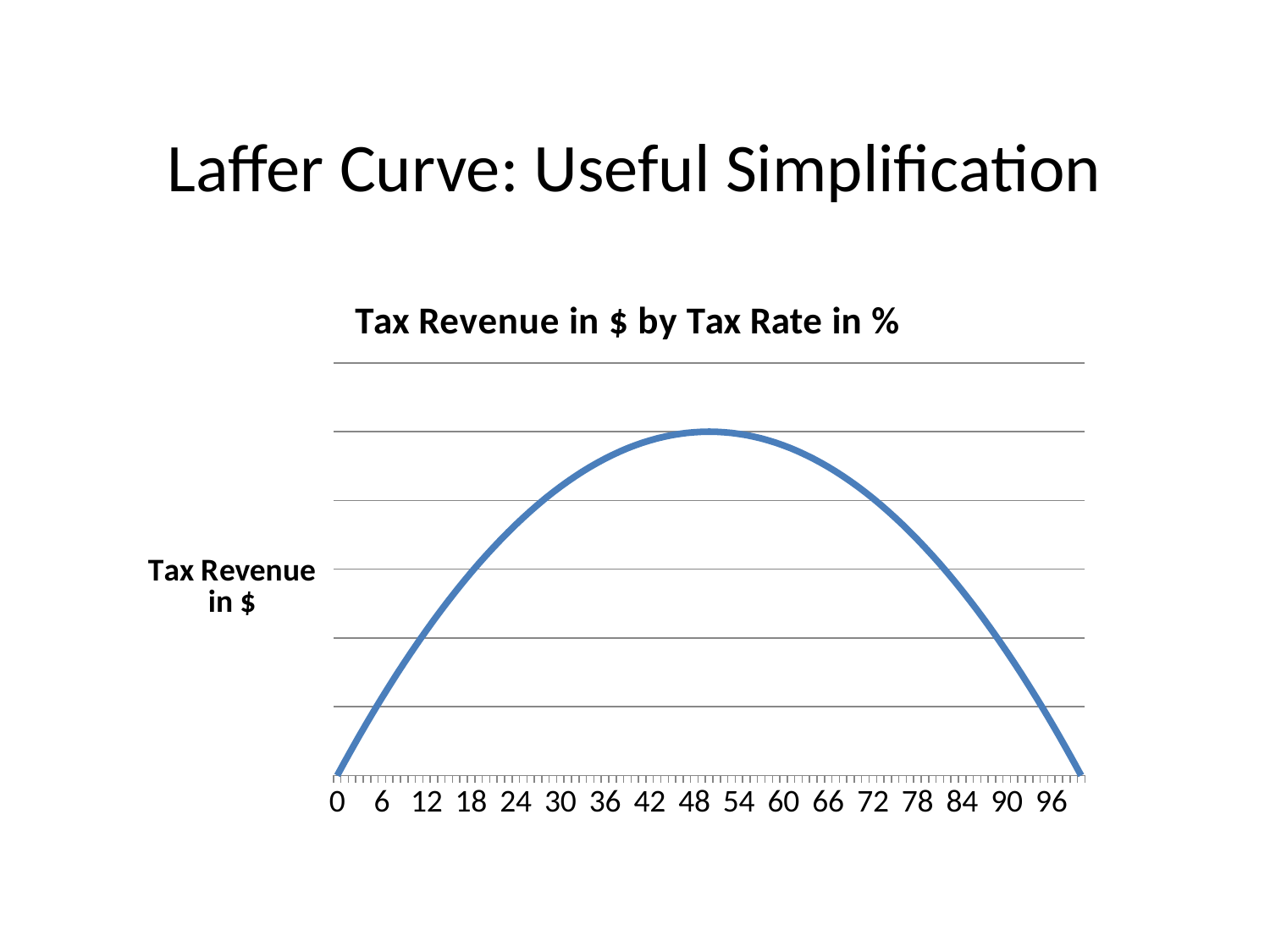
What is the title of the chart? Tax Revenue in $ by Tax Rate in % What is the last tick label printed on the x axis of the chart? 96 What is the label on the vertical axis of the chart? Tax Revenue in $ How many tick labels are printed along the x axis of the chart? 17 What kind of chart is shown on the slide? Line chart How many lines are plotted on the chart? 1 Which tax rate gives lower tax revenue, 0 or 30? 0 What is the first tick label on the x axis of the chart? 0 Between a tax rate of 0 and a tax rate of 48, does tax revenue rise or fall? Rise Which tax rate gives higher tax revenue, 96 or 60? 60 Which tax rate gives higher tax revenue, 12 or 48? 48 Between a tax rate of 54 and a tax rate of 96, does tax revenue rise or fall? Fall